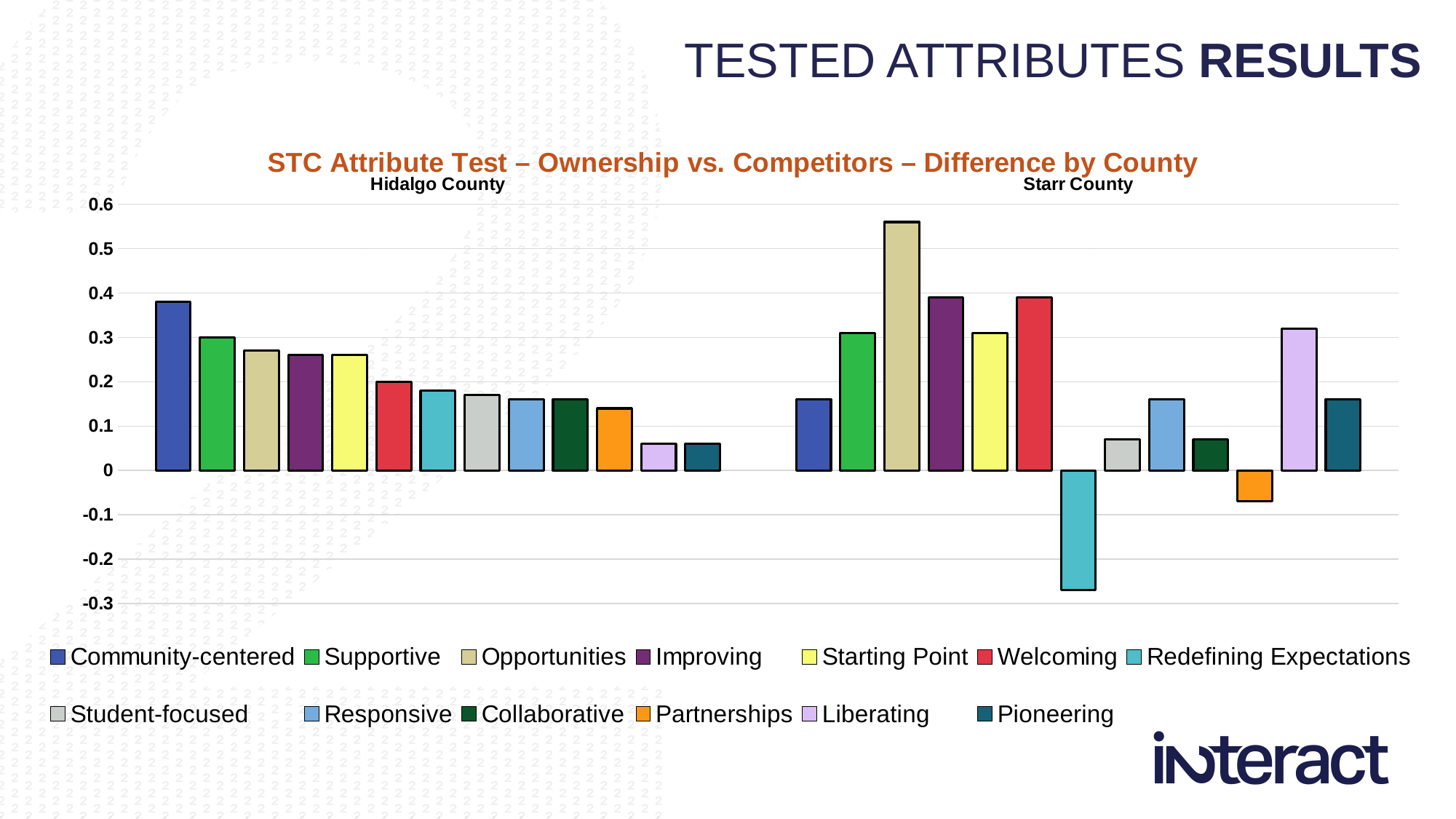
How many county categories are plotted on the x axis? 2 Is the value for Community-centered in Hidalgo County greater or less than 0.3? greater Which county has the larger value for Community-centered, Hidalgo County or Starr County? Hidalgo County What is the title of the chart? STC Attribute Test – Ownership vs. Competitors – Difference by County How many series does the legend list? 13 Is the value for Redefining Expectations in Starr County greater or less than -0.2? less Which attribute has the highest value for Starr County? Opportunities Which county has the larger value for Opportunities, Hidalgo County or Starr County? Starr County Which attribute has the highest value for Hidalgo County? Community-centered What kind of chart is shown on the slide? Bar chart Which attribute has the lowest value for Starr County? Redefining Expectations Is the value for Opportunities in Starr County greater or less than 0.5? greater